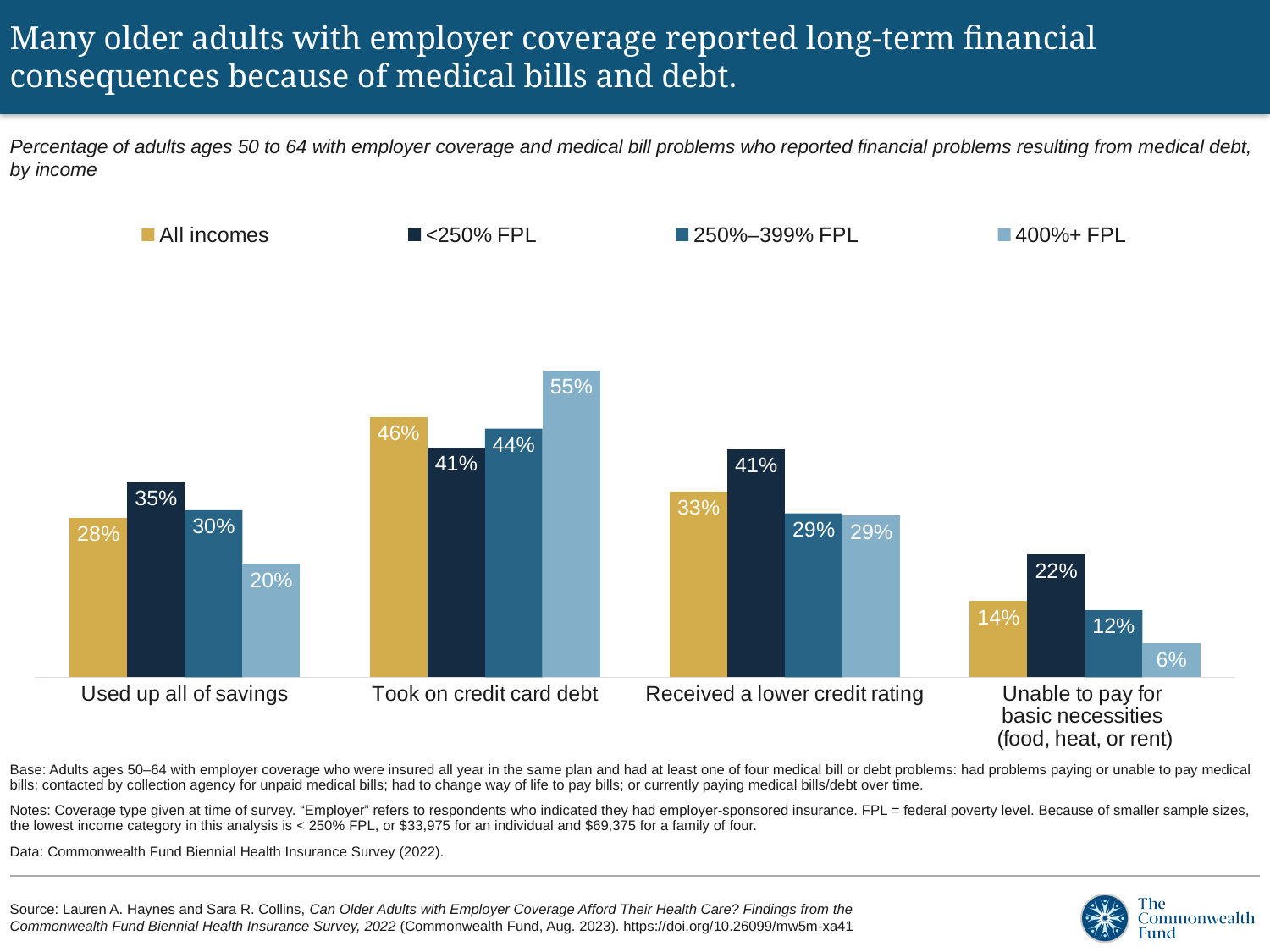
What percentage of the <250% FPL group reported being unable to pay for basic necessities? 22% Which income group has the highest value for 'Received a lower credit rating'? <250% FPL What is the value for the 400%+ FPL group for 'Took on credit card debt'? 55% Which legend entry is shown in gold/yellow? All incomes What is the difference between the <250% FPL and 250%–399% FPL values for 'Received a lower credit rating'? 12 percentage points What is the difference between the 400%+ FPL and All incomes values for 'Took on credit card debt'? 9 percentage points Which is larger for 'Unable to pay for basic necessities': the 250%–399% FPL value or the 400%+ FPL value? 250%–399% FPL What kind of chart is shown on the slide? Bar chart How many categories are shown on the x axis? 4 What percentage of adults with all incomes reported using up all of their savings? 28% Which income group has the lowest value for 'Used up all of savings'? 400%+ FPL How many series does the legend list? 4